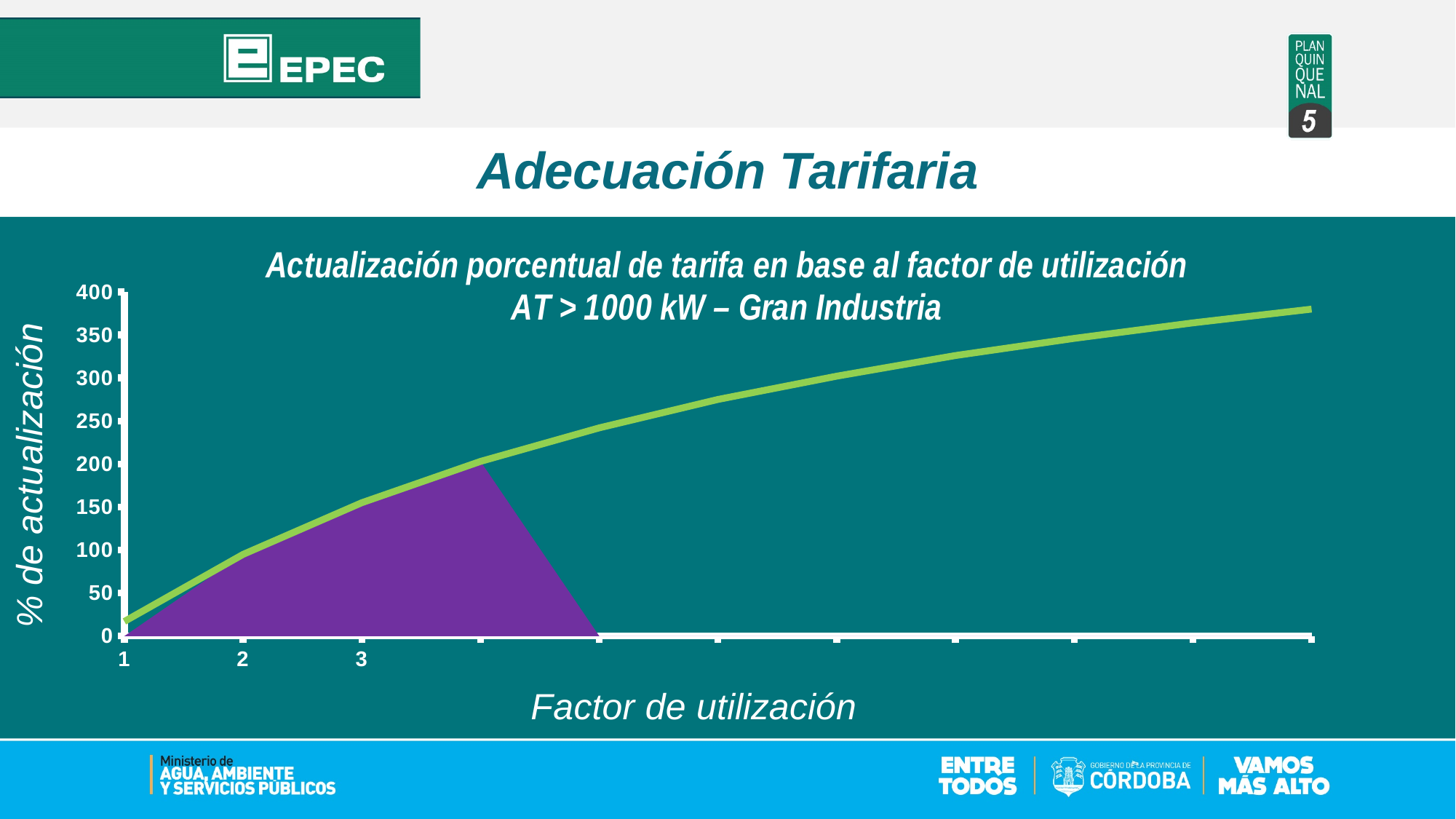
Is the value for factor de utilización 2 greater or less than 50? greater Does the % de actualización rise or fall as the factor de utilización increases? rise Is the value for factor de utilización 2 greater or less than 150? less What kind of chart is shown on the slide? area and line chart Which has the larger % de actualización, factor de utilización 2 or 3? 3 What is the label of the x axis? Factor de utilización Is the value for factor de utilización 3 greater or less than 200? less Among the labeled factors 1, 2 and 3, which has the lowest % de actualización? 1 What is the title of the chart? Actualización porcentual de tarifa en base al factor de utilización AT > 1000 kW – Gran Industria